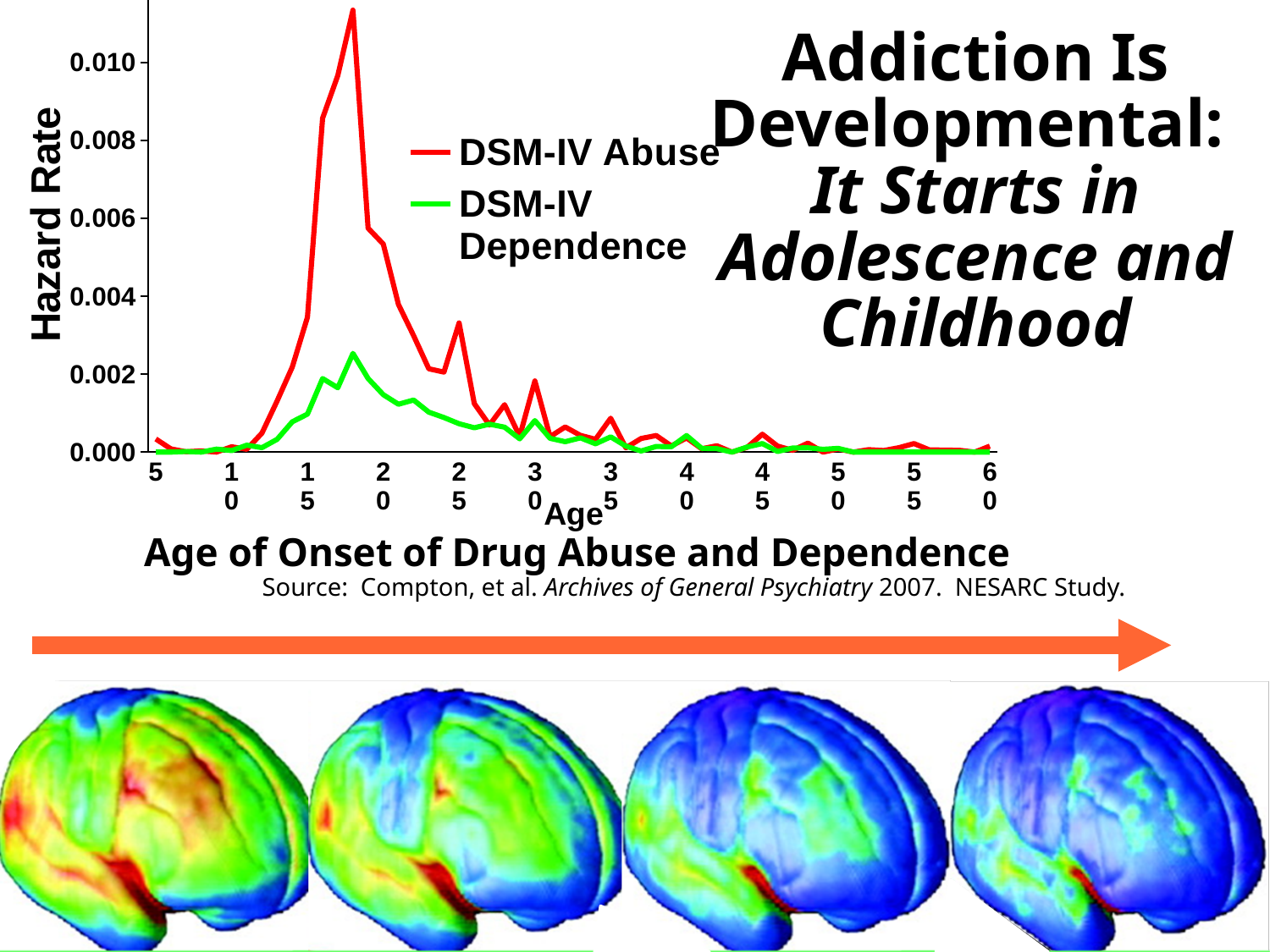
What is the label on the vertical axis of the chart? Hazard Rate What are the two series named in the legend? DSM-IV Abuse and DSM-IV Dependence After the peak, do the hazard rates rise or fall as age increases toward 60? fall Is the peak value of the DSM-IV Abuse line greater or less than 0.010? greater Is the peak value of the DSM-IV Dependence line greater or less than 0.002? greater What kind of chart is shown on the slide? line chart Between which two age ticks on the x axis does the DSM-IV Abuse line reach its peak? 15 and 20 Is the peak value of the DSM-IV Dependence line greater or less than 0.004? less Which series reaches the higher peak hazard rate, DSM-IV Abuse or DSM-IV Dependence? DSM-IV Abuse How many series does the legend list? 2 Which series has the lower hazard rate at age 20, DSM-IV Abuse or DSM-IV Dependence? DSM-IV Dependence